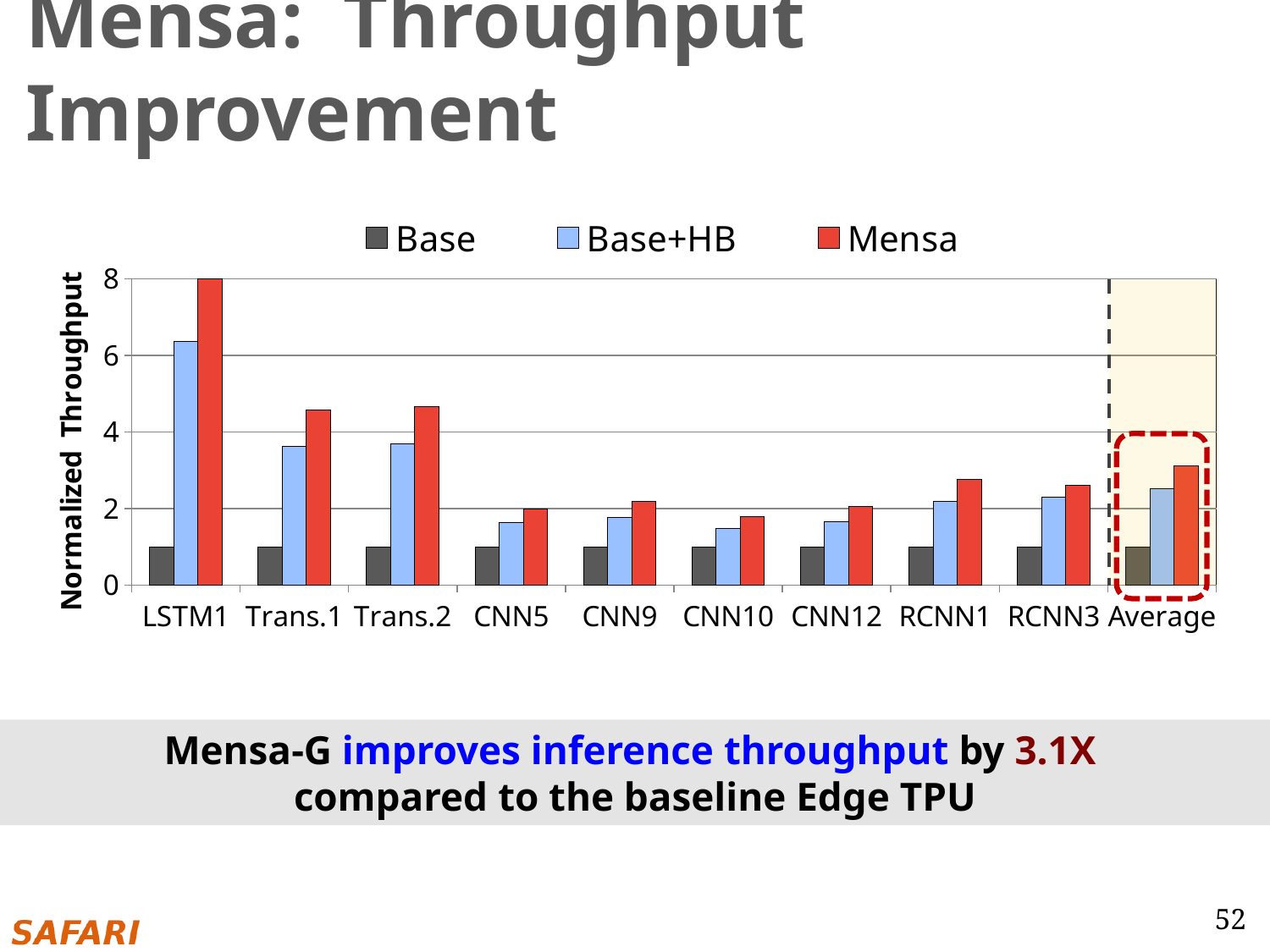
What is the label of the y axis? Normalized Throughput Which is larger, the Mensa value for Trans.2 or the Mensa value for RCNN1? Trans.2 Which is larger for CNN12, the Base+HB value or the Mensa value? Mensa How many series does the legend list? 3 Which category has the highest Mensa value? LSTM1 Is the Base+HB value for LSTM1 greater or less than 6? greater What kind of chart is shown on the slide? bar chart How many categories are shown on the x axis? 10 Is the Mensa value for Trans.1 greater or less than 4? greater Is the Base+HB value for Trans.2 greater or less than 4? less Which category has the highest Base+HB value? LSTM1